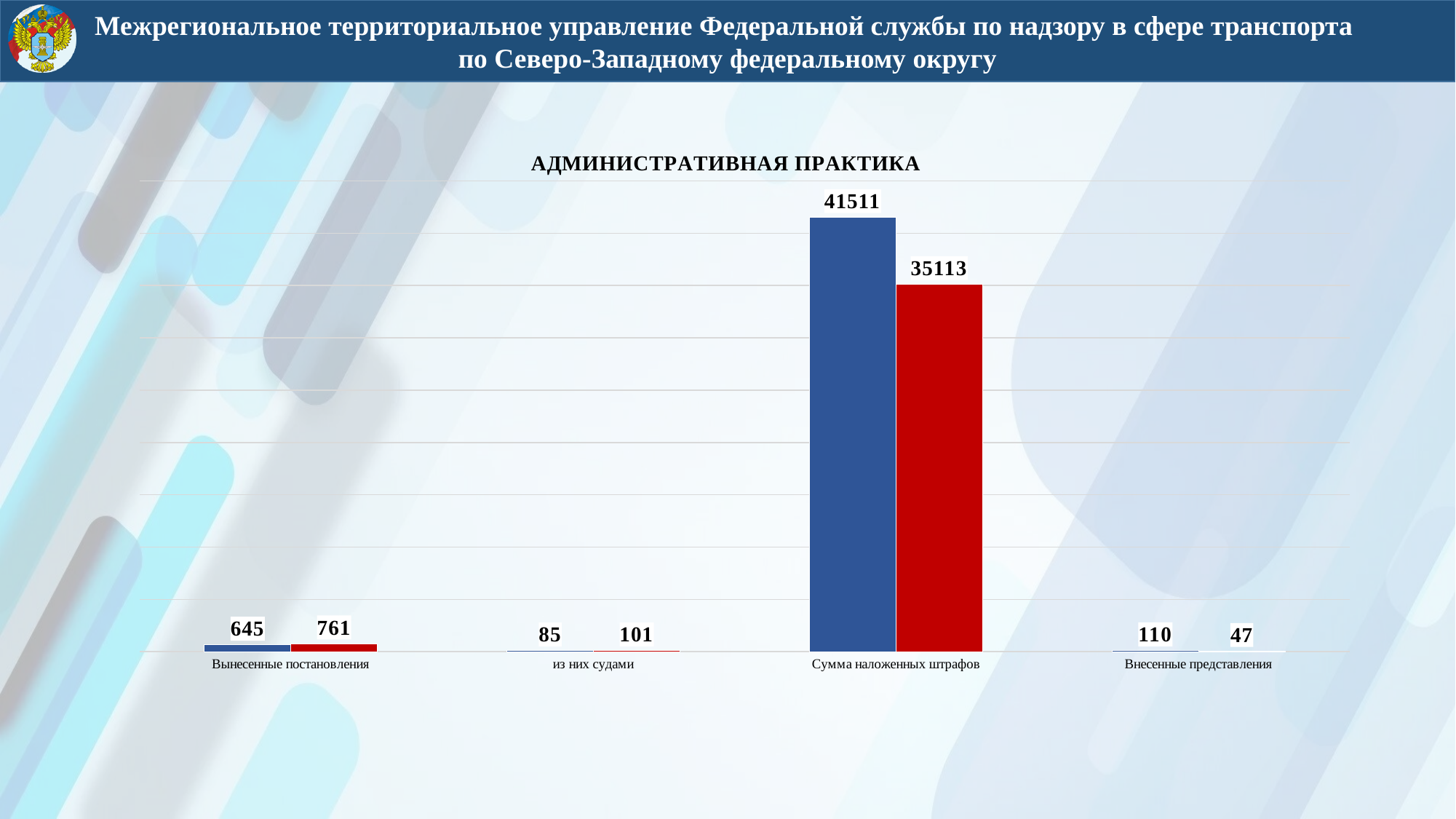
What is the value of the red bar for "из них судами"? 101 What is the value of the blue bar for "Сумма наложенных штрафов"? 41511 What is the value of the red bar for "Внесенные представления"? 47 What is the value of the blue bar for "Вынесенные постановления"? 645 Which category has the lowest red bar? Внесенные представления What is the value of the red bar for "Вынесенные постановления"? 761 How many categories are shown on the x axis? 4 Which category has the highest blue bar? Сумма наложенных штрафов What type of chart is shown on the slide? bar chart What is the difference between the blue and red bars for "Сумма наложенных штрафов"? 6398 What is the difference between the red and blue bars for "Вынесенные постановления"? 116 For "Внесенные представления", which bar is larger, blue or red? blue